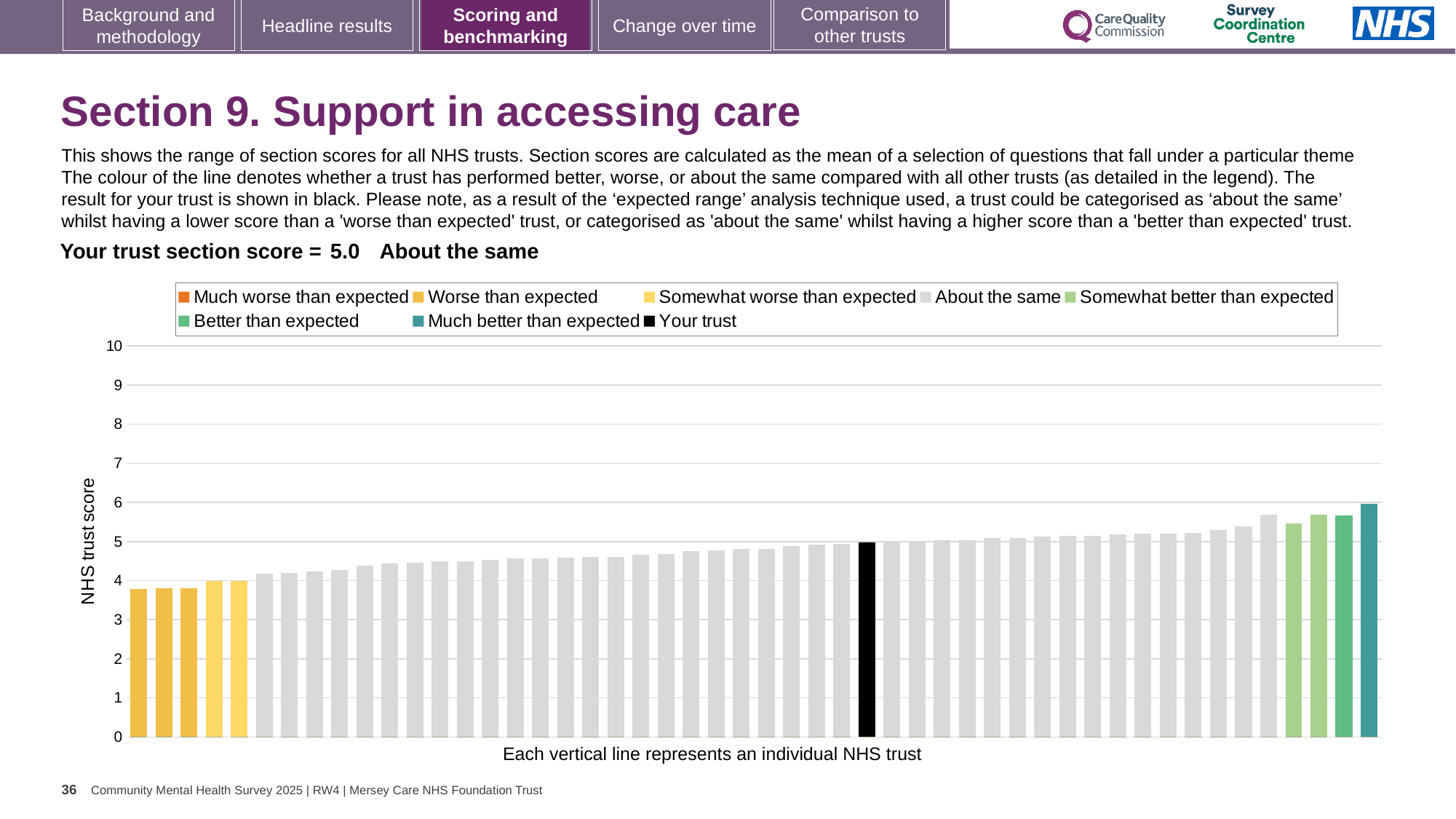
What is the label on the vertical axis of the chart? NHS trust score Which is larger, the leftmost bar or the rightmost bar? the rightmost bar Is the value of the leftmost bar greater or less than 4? less How many entries does the chart legend list? 8 What kind of chart is shown on the slide? bar chart Do the bar values rise or fall from left to right across the chart? rise Which category is your trust placed in according to the slide? About the same What is the section score for your trust shown on the slide? 5.0 Is the value of the tallest bar greater or less than 7? less Which legend category does the tallest bar belong to? Much better than expected What does the caption below the chart say each vertical line represents? an individual NHS trust Is the value of the black bar (your trust) greater or less than 4? greater